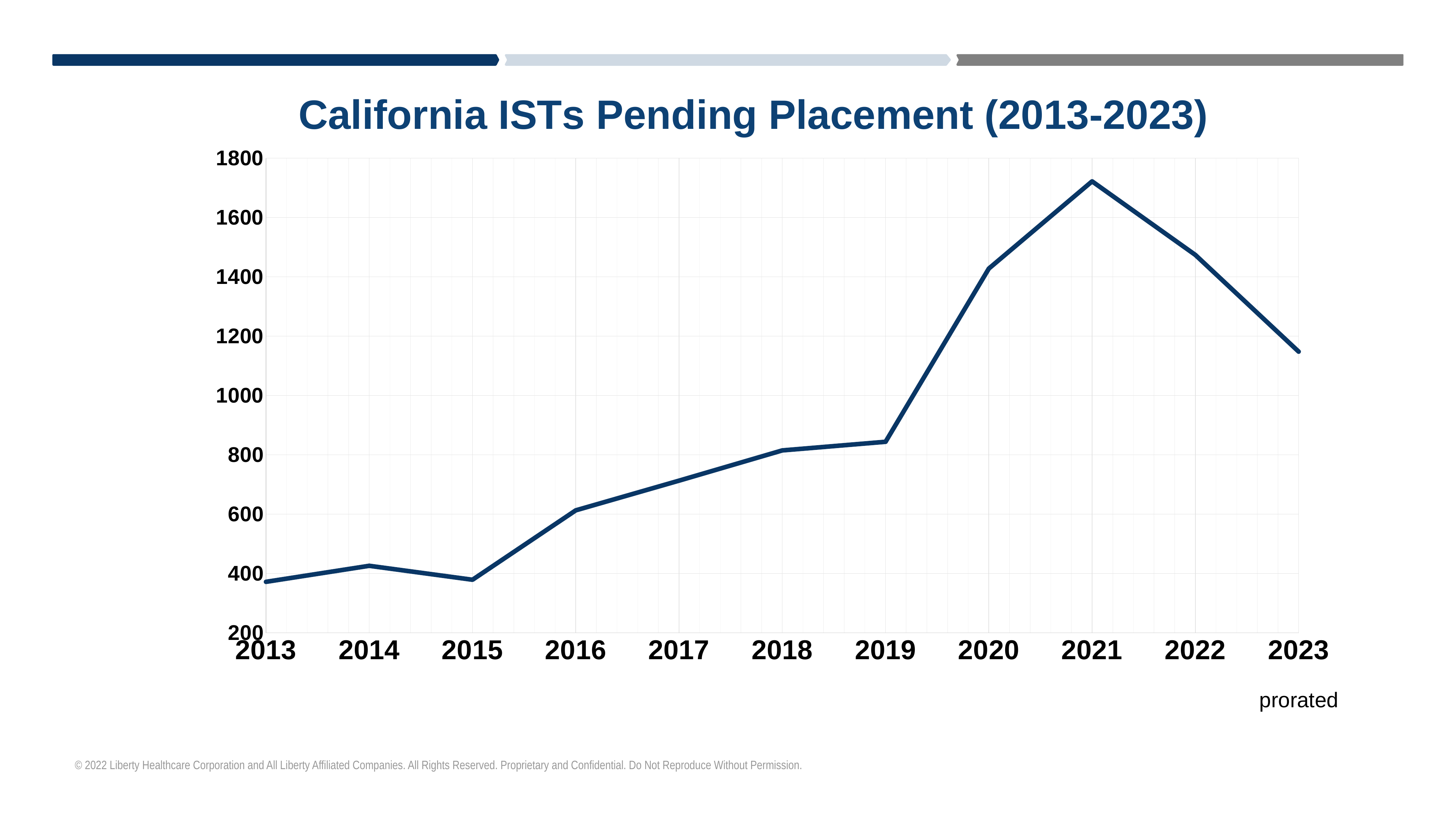
What is the title of the chart? California ISTs Pending Placement (2013-2023) Is the value for 2023 greater or less than 1200? less Do the values rise or fall from 2021 to 2023? fall Is the value for 2017 greater or less than 800? less Which year has the larger value, 2019 or 2020? 2020 Which year has the larger value, 2022 or 2023? 2022 Is the value for 2021 greater or less than 1600? greater How many years are plotted on the x axis? 11 Which year has the highest number of ISTs pending placement? 2021 What kind of chart is shown on the slide? line chart